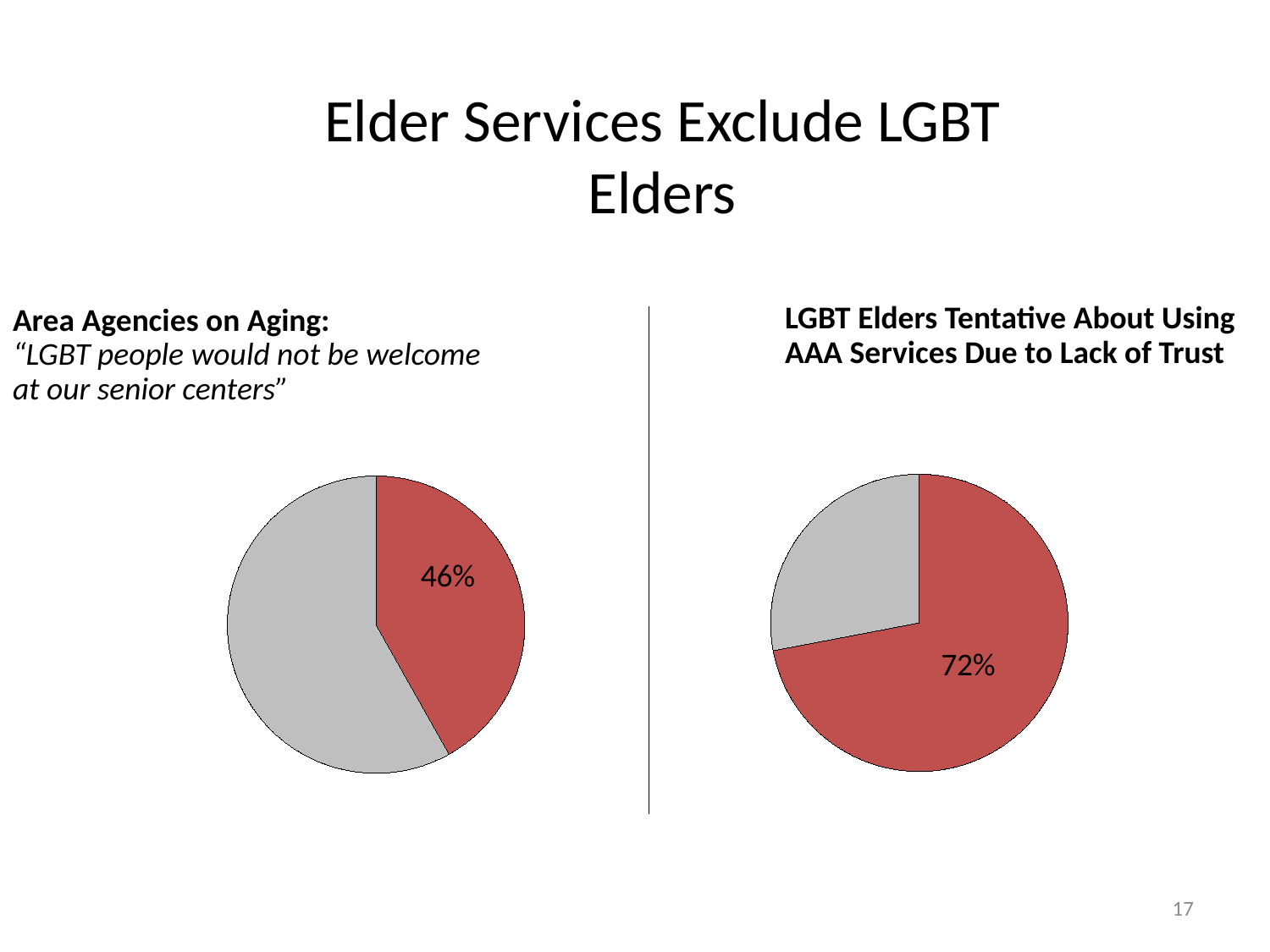
Is the labeled value in the left pie chart greater or less than 50%? less In the right pie chart (LGBT Elders Tentative About Using AAA Services), what percentage is printed on the red slice? 72% In the left pie chart (Area Agencies on Aging), what percentage is printed on the red slice? 46% What is the difference between the labeled value in the right pie chart (72%) and the labeled value in the left pie chart (46%)? 26 percentage points In the left pie chart, which slice is larger, the red slice or the grey slice? the grey slice How many slices does the left pie chart have? 2 How many slices does the right pie chart have? 2 What kind of chart is shown under the title "LGBT Elders Tentative About Using AAA Services Due to Lack of Trust"? pie chart What colour is the labeled slice in both pie charts? red Which pie chart has the larger labeled red slice, the left one (46%) or the right one (72%)? the right one (72%) In the right pie chart, which slice is larger, the red slice or the grey slice? the red slice What kind of chart is shown on the left side of the slide? pie chart